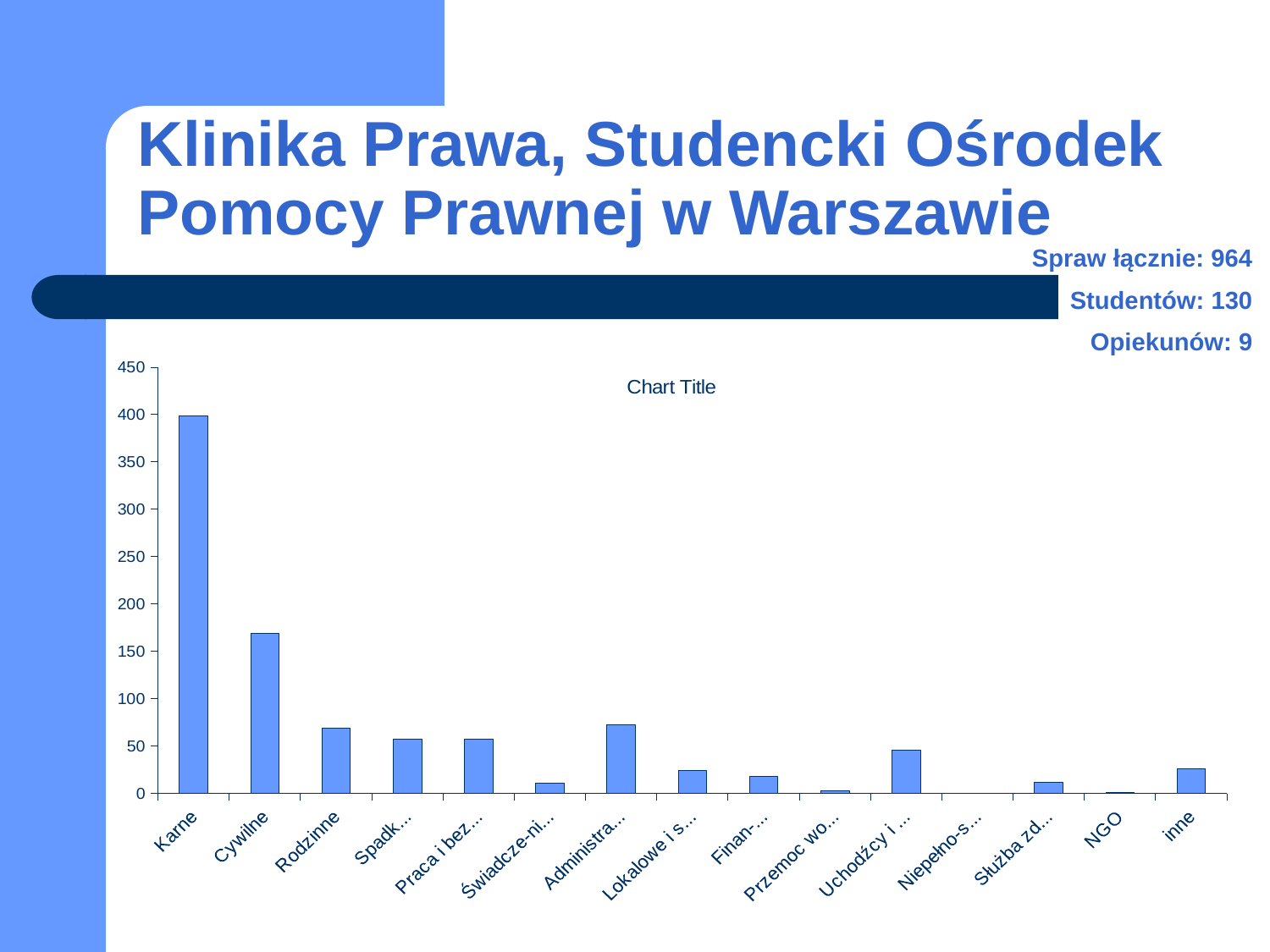
Which category has the highest bar in the chart? Karne What title is displayed on the chart? Chart Title Is the value for Karne greater or less than 350? greater Is the value for inne greater or less than 50? less Which is larger, the value for Rodzinne or the value for inne? Rodzinne What kind of chart is shown on the slide? bar chart Is the value for Cywilne greater or less than 150? greater How many categories are plotted on the x axis of the chart? 15 Which is larger, the value for Karne or the value for Cywilne? Karne